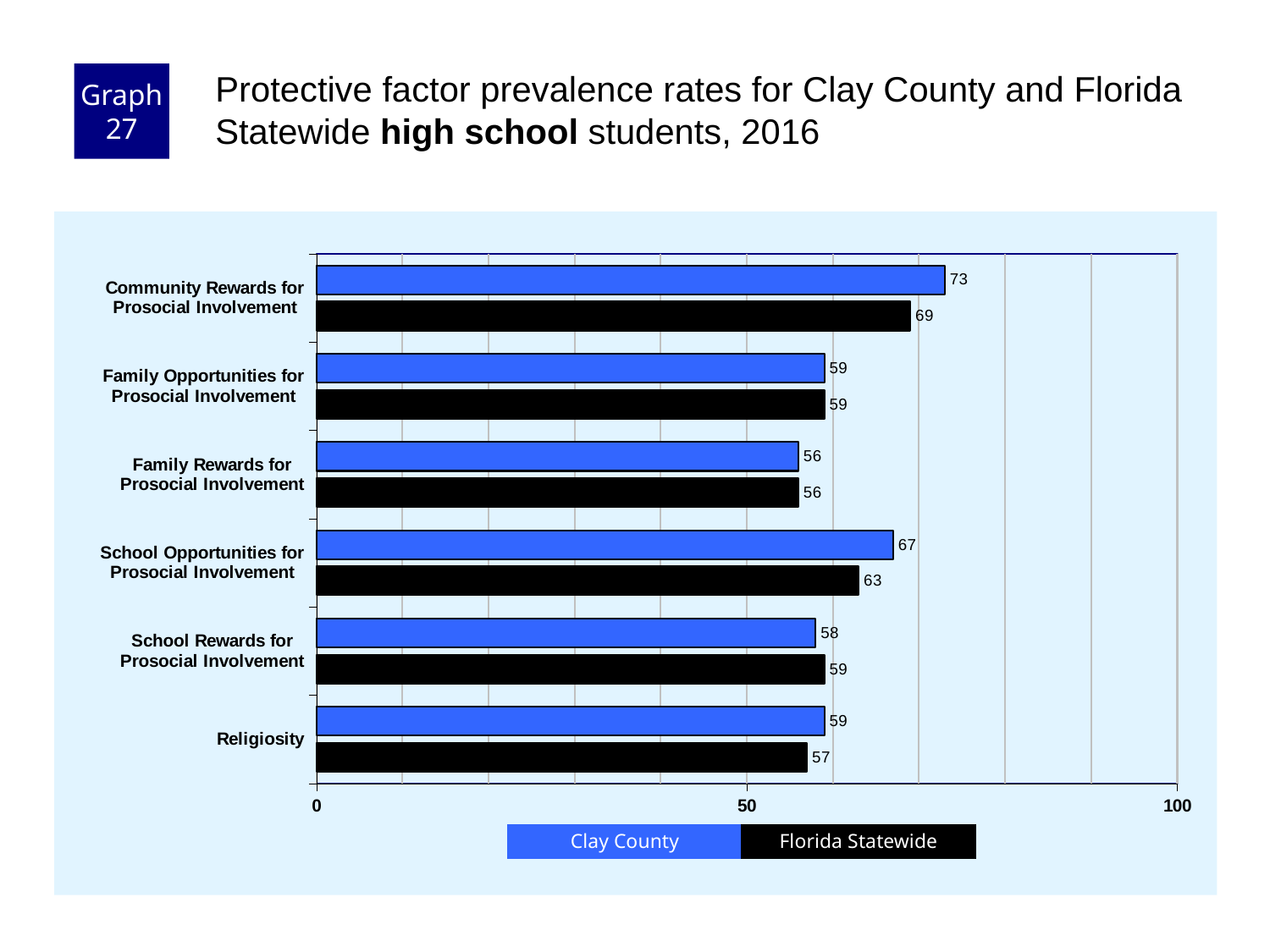
How many categories are shown on the chart? 6 What kind of chart is shown on the slide? bar chart Is the Clay County value for School Opportunities for Prosocial Involvement greater or less than 50? greater What is the difference between the Clay County and Florida Statewide values for Community Rewards for Prosocial Involvement? 4 Which colour represents Florida Statewide in the chart? black What is the Florida Statewide value for School Opportunities for Prosocial Involvement? 63 What is the Florida Statewide value for Religiosity? 57 What is the Clay County value for Community Rewards for Prosocial Involvement? 73 For School Rewards for Prosocial Involvement, which is larger: the Clay County value or the Florida Statewide value? Florida Statewide Which category has the lowest Florida Statewide value? Family Rewards for Prosocial Involvement Which category has the highest Clay County value? Community Rewards for Prosocial Involvement How many series does the legend list? 2